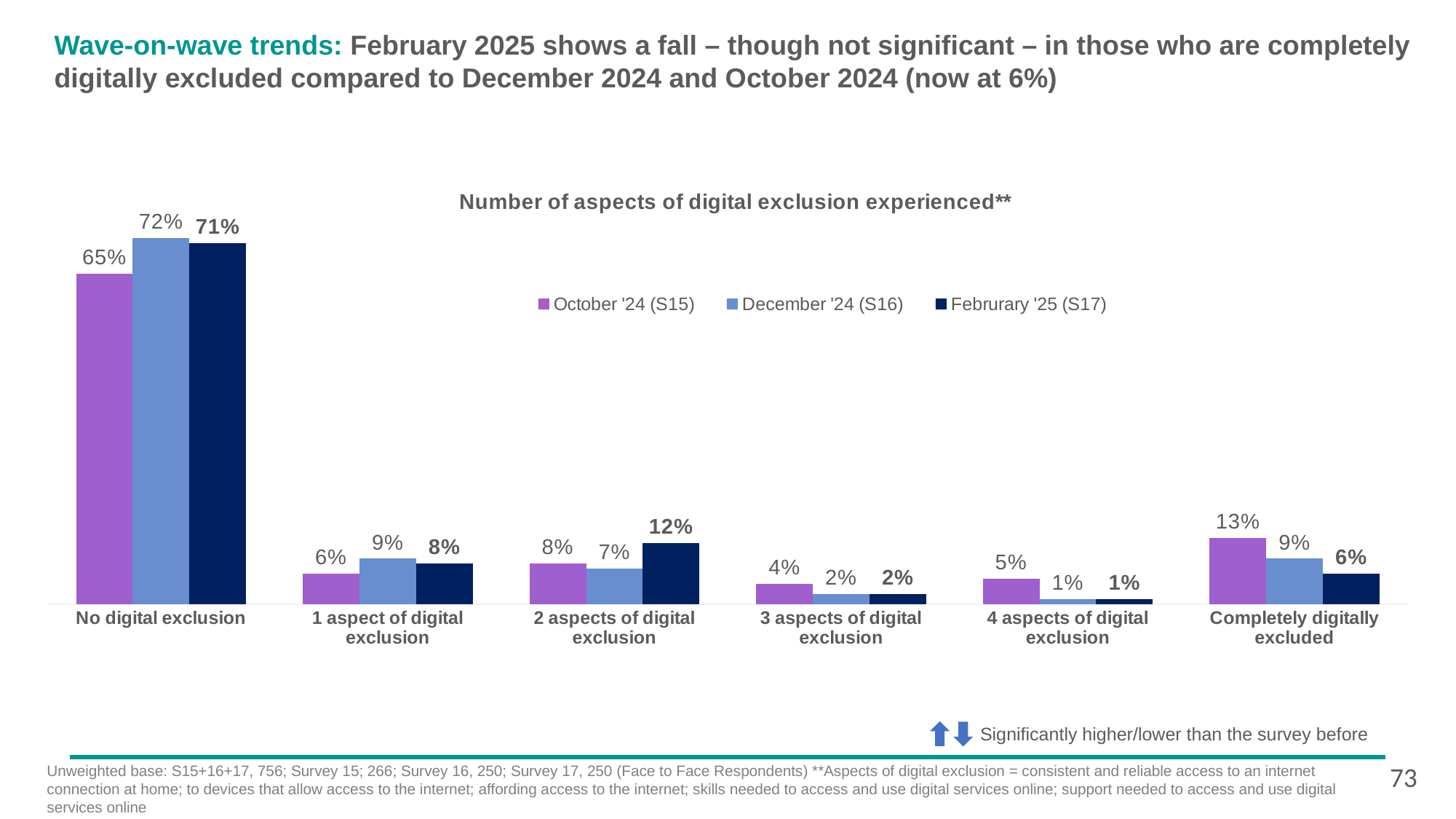
How many series does the legend list? 3 What is the title of the chart? Number of aspects of digital exclusion experienced** What is the difference between the October '24 (S15) and February '25 (S17) values for 'Completely digitally excluded'? 7% Which category has the lowest value in the February '25 (S17) series? 4 aspects of digital exclusion Which category has the highest value in the December '24 (S16) series? No digital exclusion How many categories are shown on the x axis? 6 What is the value for 'Completely digitally excluded' in the October '24 (S15) series? 13% Which is larger for '2 aspects of digital exclusion': the October '24 (S15) value or the February '25 (S17) value? February '25 (S17) What is the value for 'No digital exclusion' in the February '25 (S17) series? 71% What is the value for '2 aspects of digital exclusion' in the December '24 (S16) series? 7% What kind of chart is shown on the slide? Bar chart Which series is shown in purple? October '24 (S15)